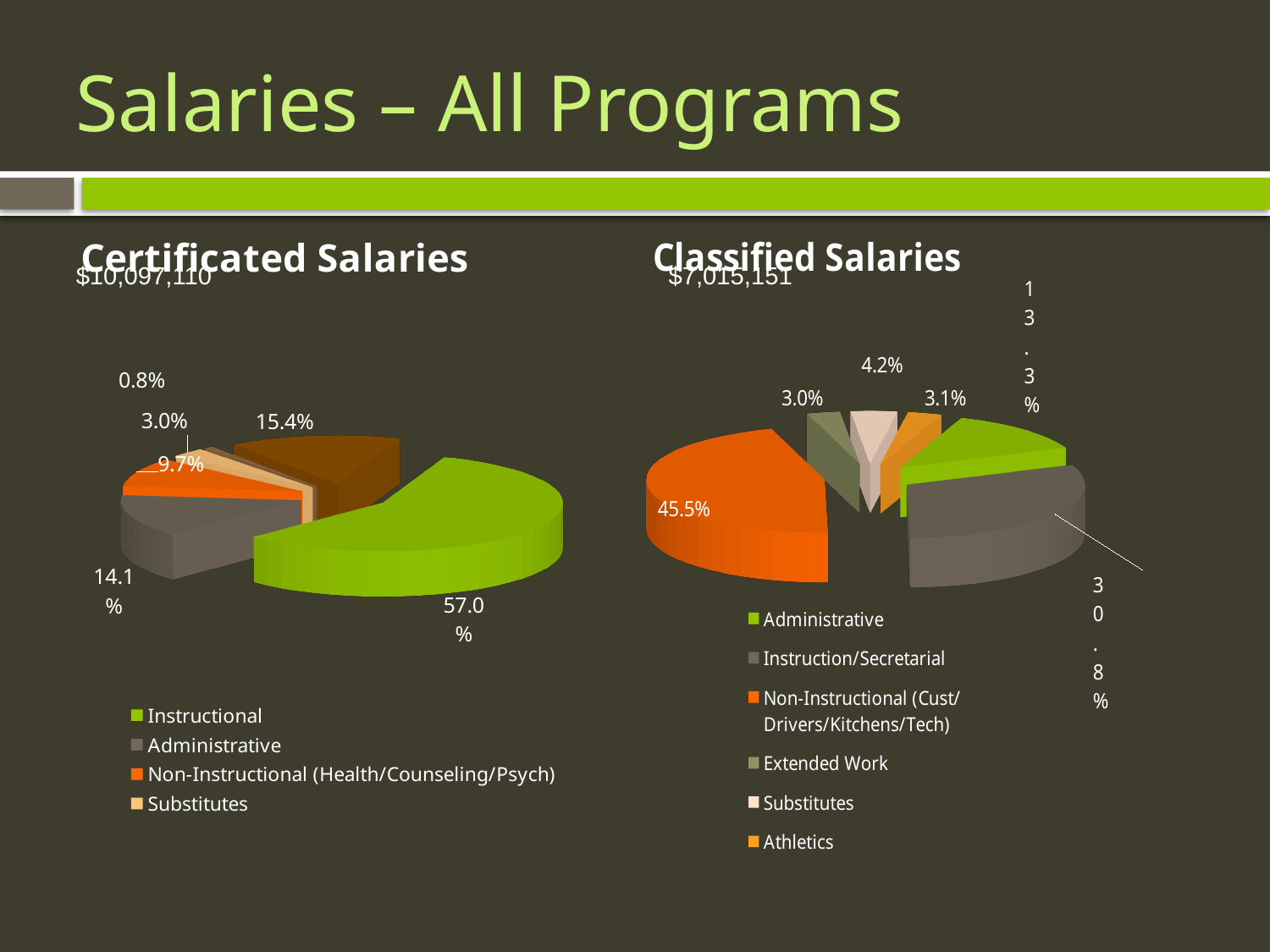
In the Certificated Salaries chart, what share is Instructional? 57.0% In the Classified Salaries chart, how many percentage points larger is Non-Instructional (Cust/Drivers/Kitchens/Tech) than Instruction/Secretarial? 14.7 percentage points In the Certificated Salaries chart, what share is Administrative? 14.1% In the Classified Salaries chart, which category has the largest slice? Non-Instructional (Cust/Drivers/Kitchens/Tech) In the Classified Salaries chart, what share is Non-Instructional (Cust/Drivers/Kitchens/Tech)? 45.5% In the Certificated Salaries chart, which is larger: Administrative or Non-Instructional (Health/Counseling/Psych)? Administrative What total dollar amount is shown for Classified Salaries? $7,015,151 How many categories does the legend of the Classified Salaries chart list? 6 In the Certificated Salaries chart, which category has the largest slice? Instructional What kind of chart is used for Certificated Salaries? Pie chart